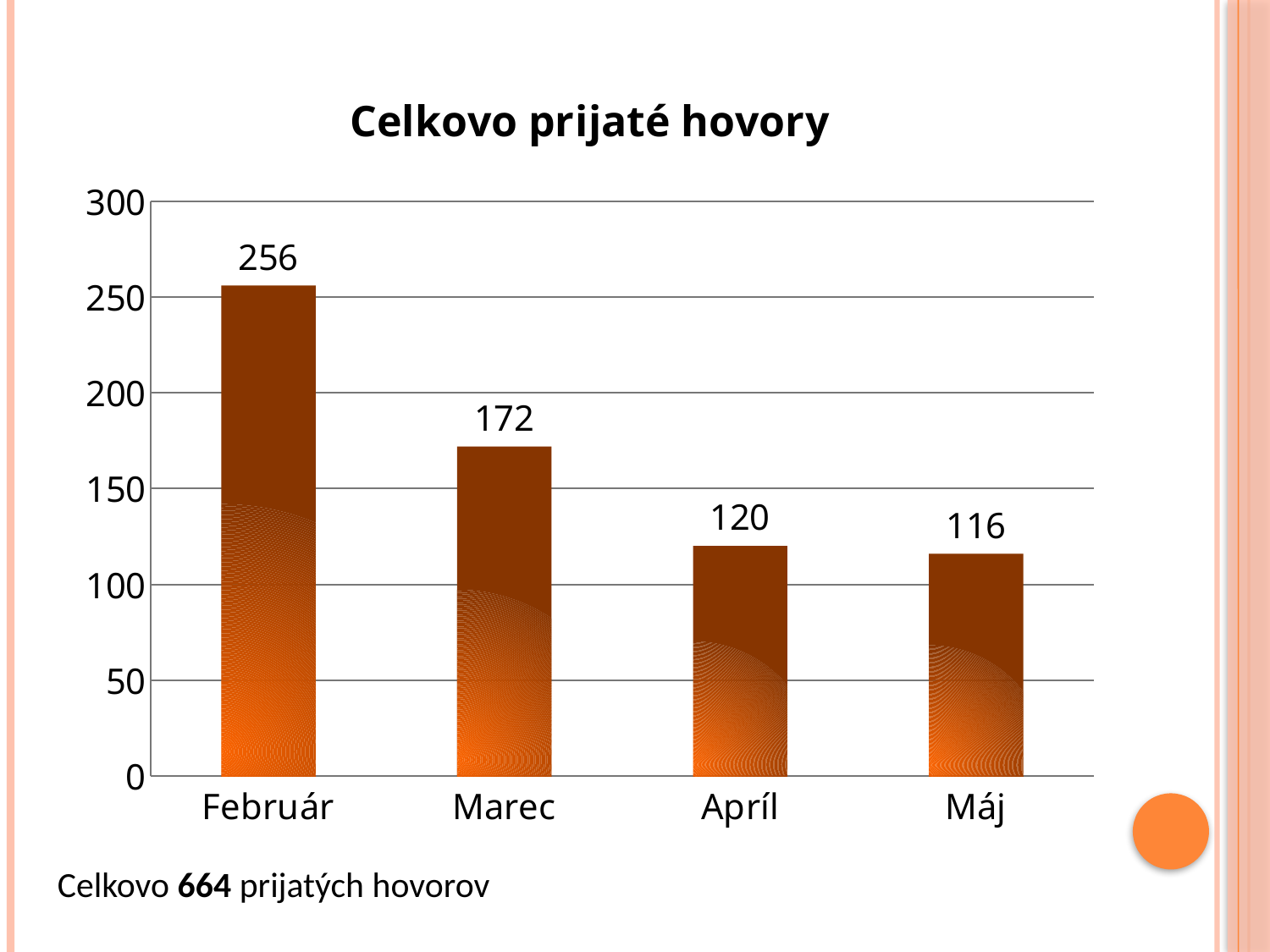
Which month has the lowest value? Máj What kind of chart is shown on the slide? Bar chart Is the value for Marec greater or less than 150? greater What is the difference between the values for Február and Marec? 84 Which month has the highest value? Február What is the value for Marec? 172 What is the value for Apríl? 120 What is the value for Máj? 116 What is the value for Február? 256 Do the values rise or fall from Február to Máj? Fall Which is larger, the value for Marec or the value for Apríl? Marec How many months are shown on the x axis? 4